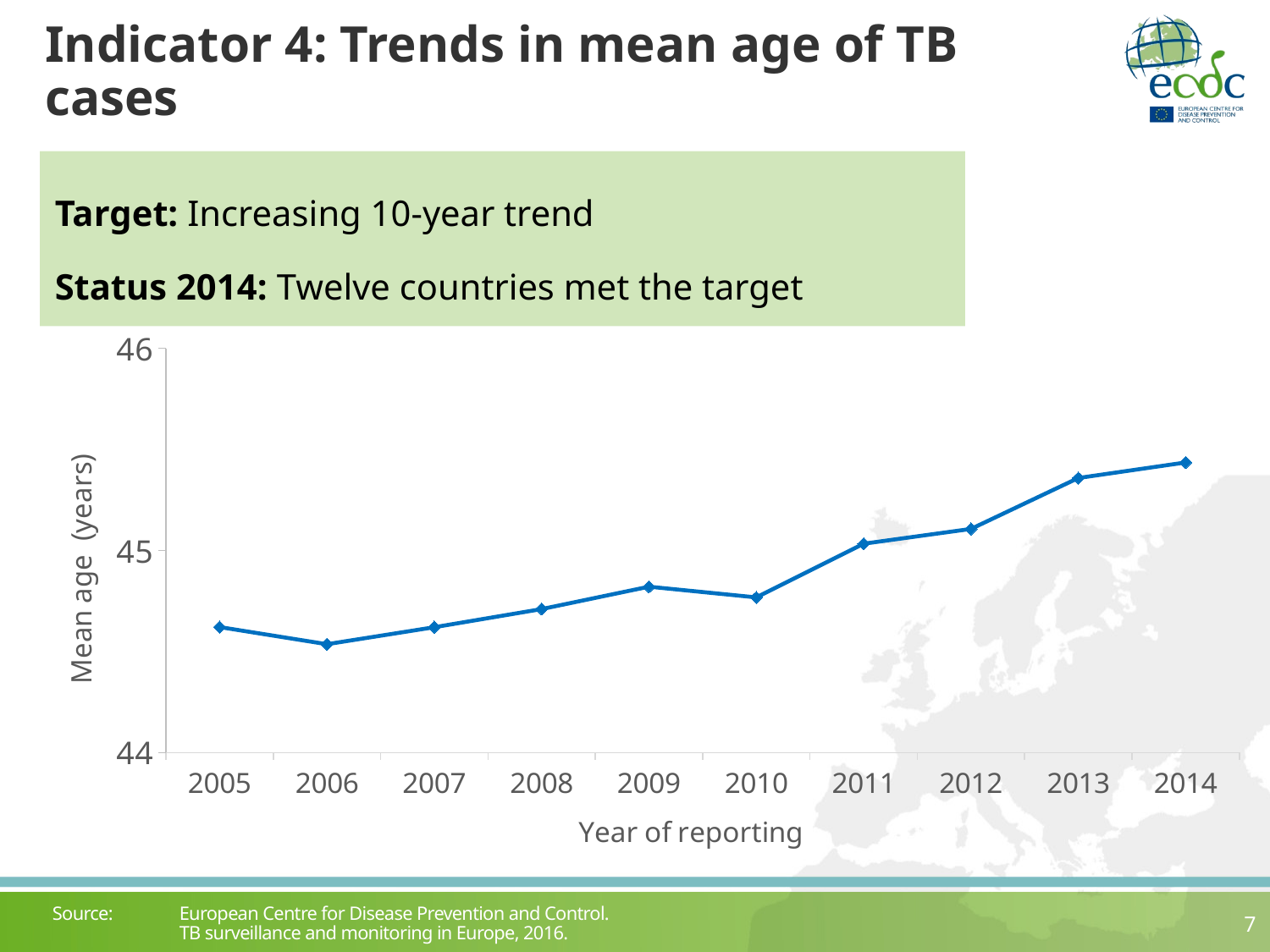
Is the mean age for 2005 greater or less than 45? less Which year has a higher mean age, 2005 or 2014? 2014 Which year has a higher mean age, 2008 or 2013? 2013 In which year is the mean age of TB cases highest? 2014 Is the mean age for 2013 greater or less than 46? less What kind of chart is shown on the slide? line chart Does the mean age of TB cases generally rise or fall from 2005 to 2014? rise Is the mean age for 2010 greater or less than 45? less In which year is the mean age of TB cases lowest? 2006 How many years are plotted on the x axis of the chart? 10 What is the label of the y axis of the chart? Mean age (years)